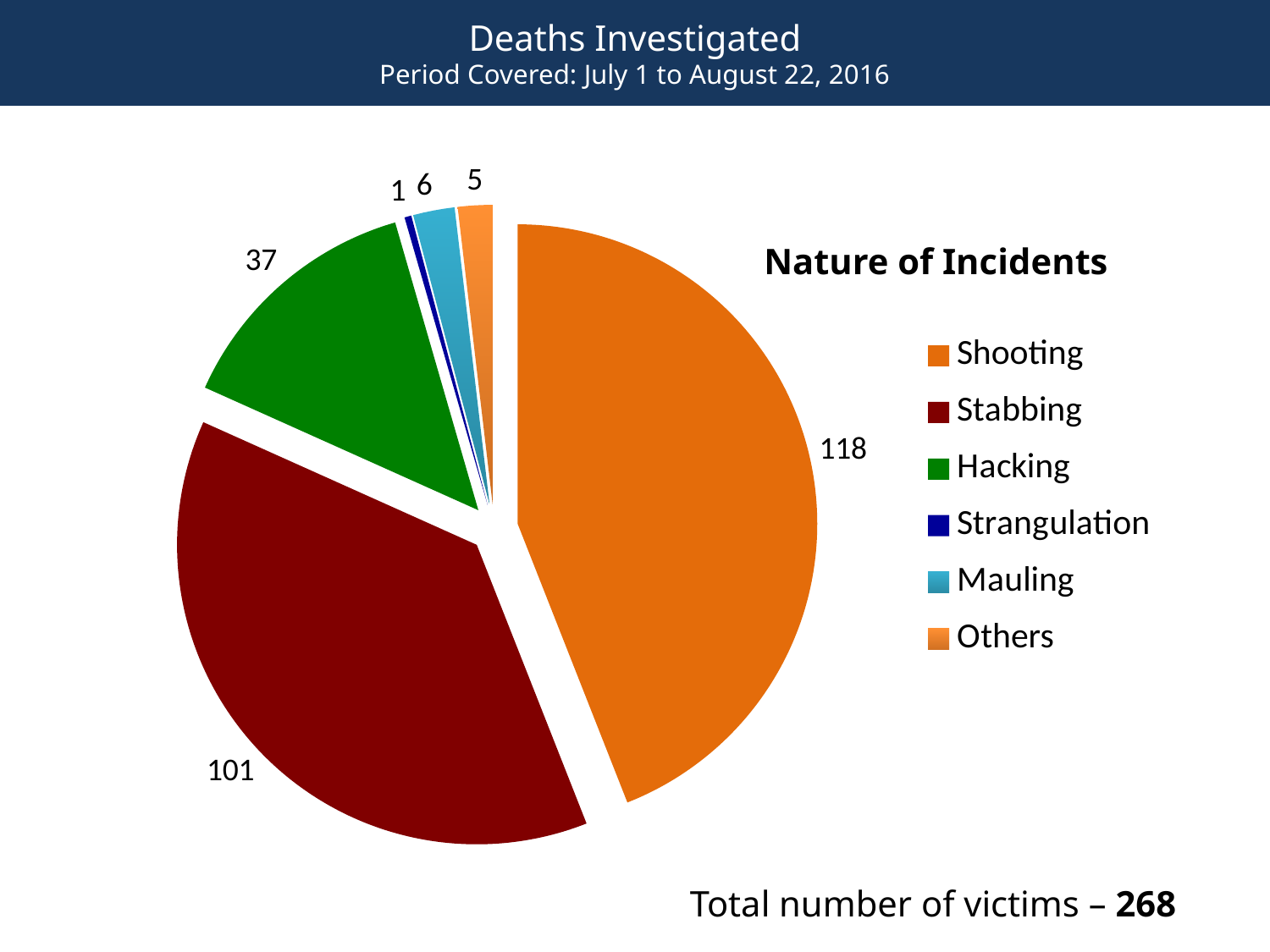
What is the difference between the values for Shooting and Stabbing? 17 What is the value for Strangulation in the pie chart? 1 What type of chart is shown on the slide? pie chart Which category has the smallest slice of the pie chart? Strangulation How many categories does the legend of the pie chart list? 6 What is the value for Mauling in the pie chart? 6 What is the value for Stabbing in the pie chart? 101 What is the value for Shooting in the pie chart? 118 What is the value for Hacking in the pie chart? 37 What is the title of the legend shown next to the pie chart? Nature of Incidents Which is larger, the value for Mauling or the value for Others? Mauling Which category has the largest slice of the pie chart? Shooting